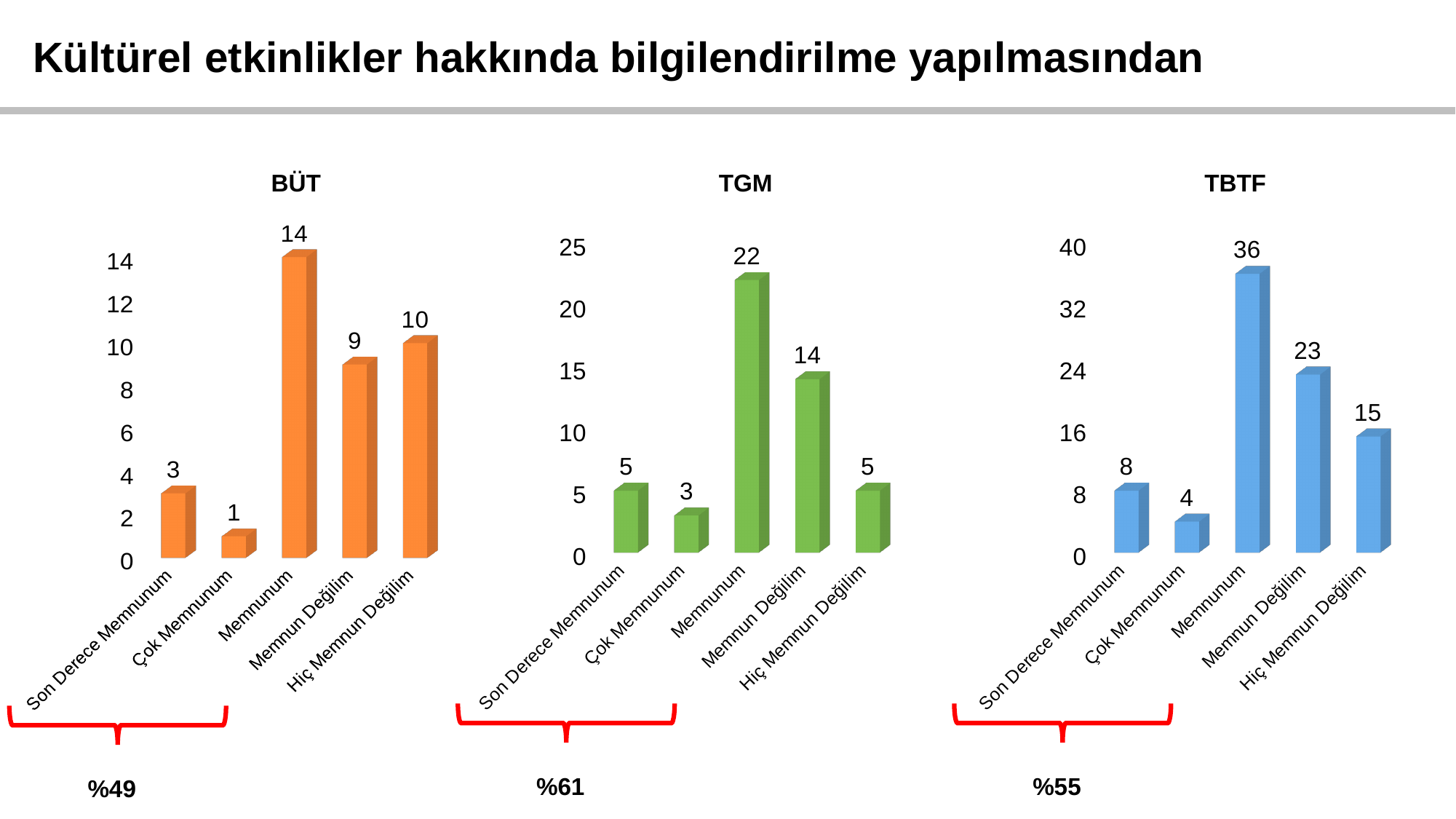
What kind of chart is the BÜT chart? bar chart In the TBTF chart, which is larger: Son Derece Memnunum or Çok Memnunum? Son Derece Memnunum In the TBTF chart, what is the total of Son Derece Memnunum and Çok Memnunum? 12 How many categories does the TGM chart show? 5 In the TGM chart, what is the value for Memnun Değilim? 14 In the TBTF chart, what is the value for Hiç Memnun Değilim? 15 What percentage is shown below the bracket under the TGM chart? %61 In the BÜT chart, which category has the lowest value? Çok Memnunum In the BÜT chart, what is the value for Memnunum? 14 In the BÜT chart, is the value for Hiç Memnun Değilim greater or less than 8? greater In the TBTF chart, which category has the highest value? Memnunum In the TGM chart, what is the difference between Memnunum and Memnun Değilim? 8